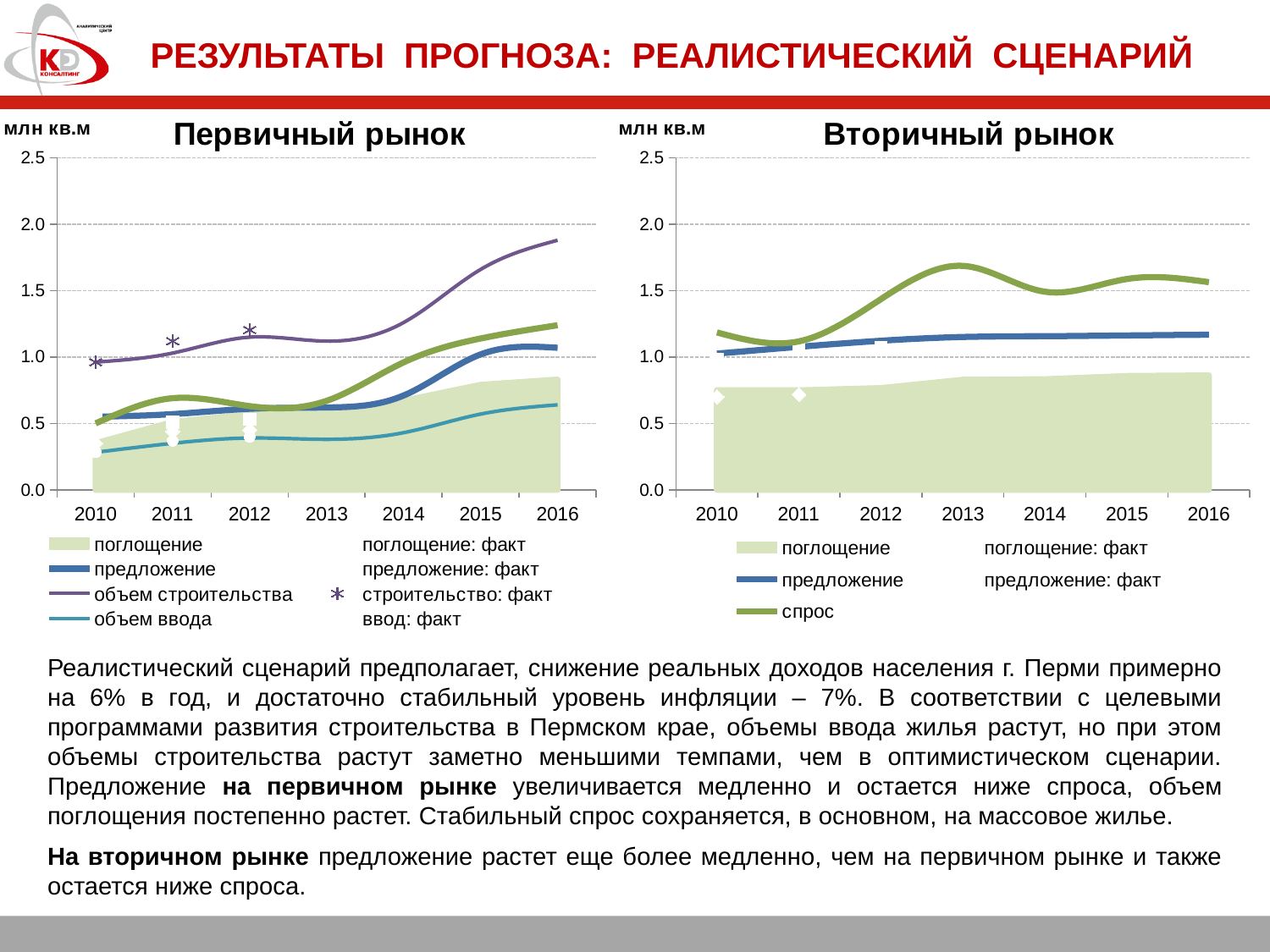
What kind of chart is the "Первичный рынок" chart? combination area and line chart In the "Первичный рынок" chart, is the value of "объем ввода" in 2010 greater or less than 0.5? less In the "Первичный рынок" chart, does "объем строительства" rise or fall from 2010 to 2016? rise In the "Вторичный рынок" chart, is the value of "поглощение" in 2016 greater or less than 1.0? less How many entries does the legend of the "Первичный рынок" chart list? 8 How many years are shown on the x axis of the "Вторичный рынок" chart? 7 What unit is shown on the y axis of both charts? млн кв.м In the "Вторичный рынок" chart, is the value of "спрос" in 2013 greater or less than 1.5? greater In the "Вторичный рынок" chart, which is higher in 2016: "спрос" or "предложение"? спрос In the "Первичный рынок" chart, which is higher in 2016: "объем строительства" or "предложение"? объем строительства How many entries does the legend of the "Вторичный рынок" chart list? 5